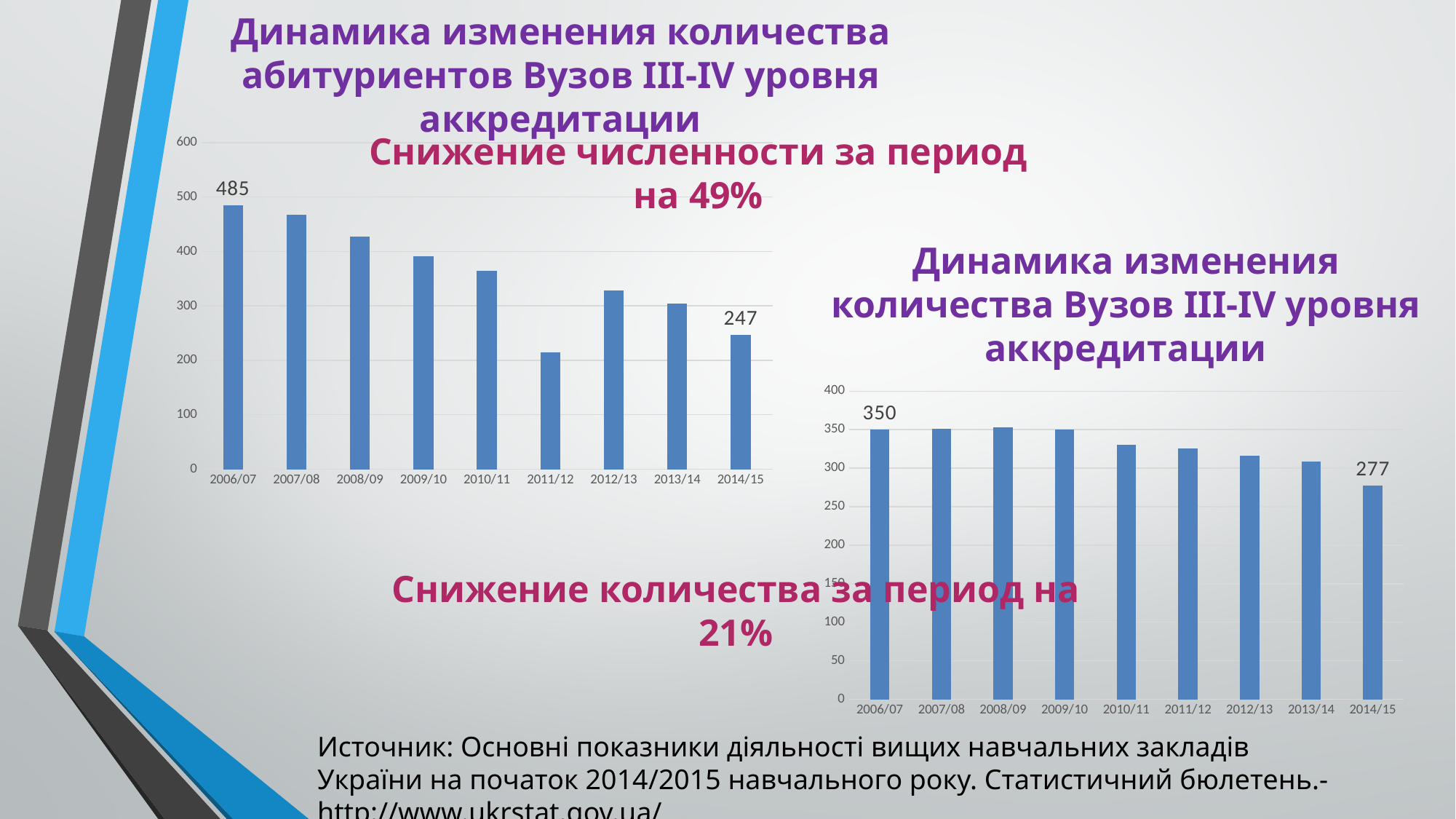
In the right chart (Динамика изменения количества Вузов), what is the difference between the 2006/07 and 2014/15 values? 73 In the left chart (Динамика изменения количества абитуриентов), what is the difference between the 2006/07 and 2014/15 values? 238 In the left chart (Динамика изменения количества абитуриентов), how many years are shown on the x axis? 9 In the left chart (Динамика изменения количества абитуриентов), what is the value for 2006/07? 485 In the left chart (Динамика изменения количества абитуриентов), is the value for 2012/13 greater or less than 300? greater In the right chart (Динамика изменения количества Вузов), which year has the lowest value? 2014/15 In the left chart (Динамика изменения количества абитуриентов), which year has the highest value? 2006/07 In the right chart (Динамика изменения количества Вузов), what is the value for 2006/07? 350 In the left chart (Динамика изменения количества абитуриентов), which year has the lowest value? 2011/12 What type of chart is the right chart (Динамика изменения количества Вузов)? bar chart In the left chart (Динамика изменения количества абитуриентов), what is the value for 2014/15? 247 In the right chart (Динамика изменения количества Вузов), what is the value for 2014/15? 277